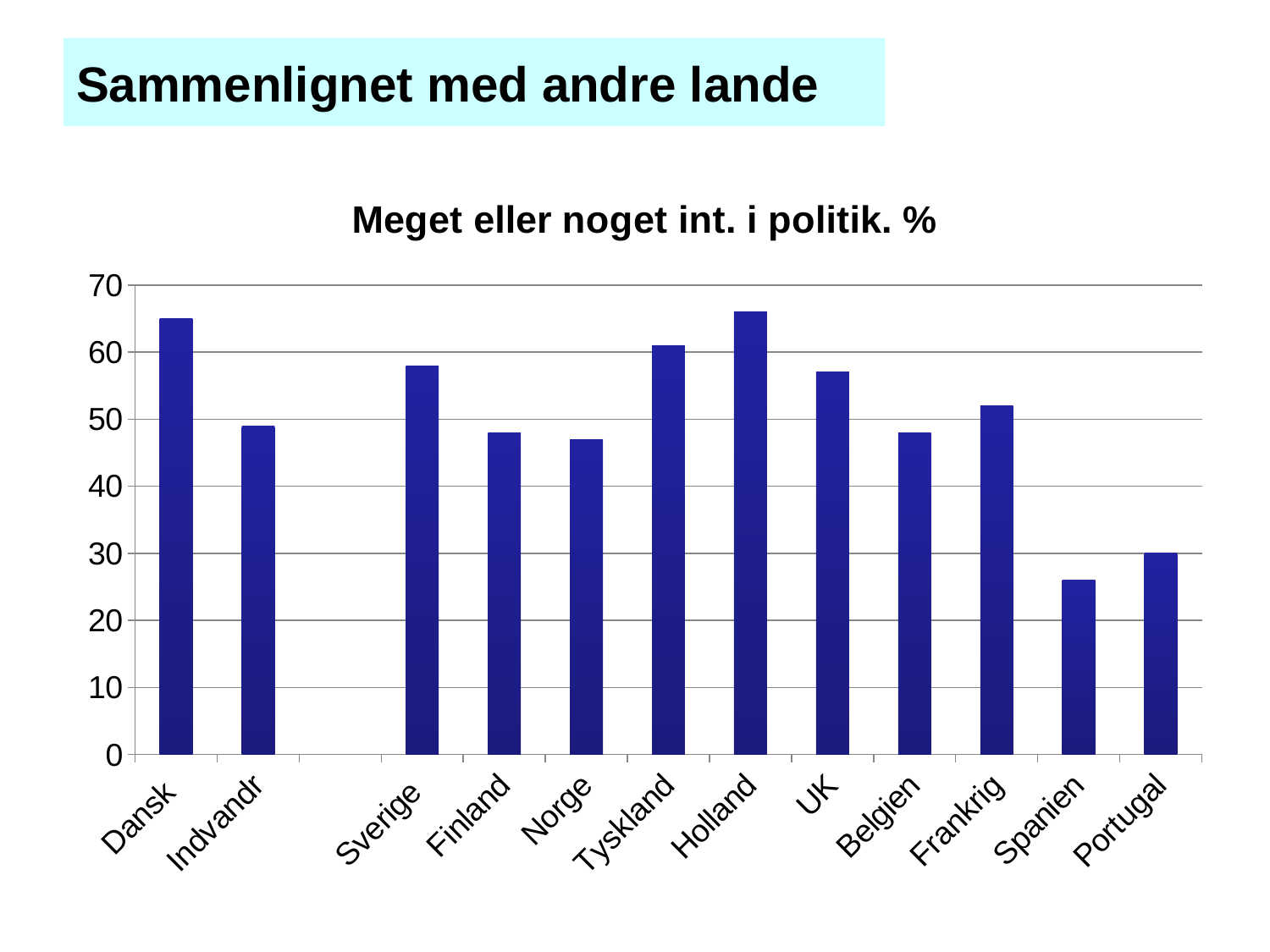
Which is larger, the value for Spanien or the value for Portugal? Portugal How many countries/categories are plotted in the chart? 12 What is the title of the chart? Meget eller noget int. i politik. % Is the value for Dansk greater or less than 60? greater Which category has the lowest value in the chart? Spanien What kind of chart is shown on the slide? bar chart Is the value for Norge greater or less than 50? less Is the value for Spanien greater or less than 30? less Which is larger, the value for Dansk or the value for Indvandr? Dansk Which is larger, the value for Tyskland or the value for UK? Tyskland